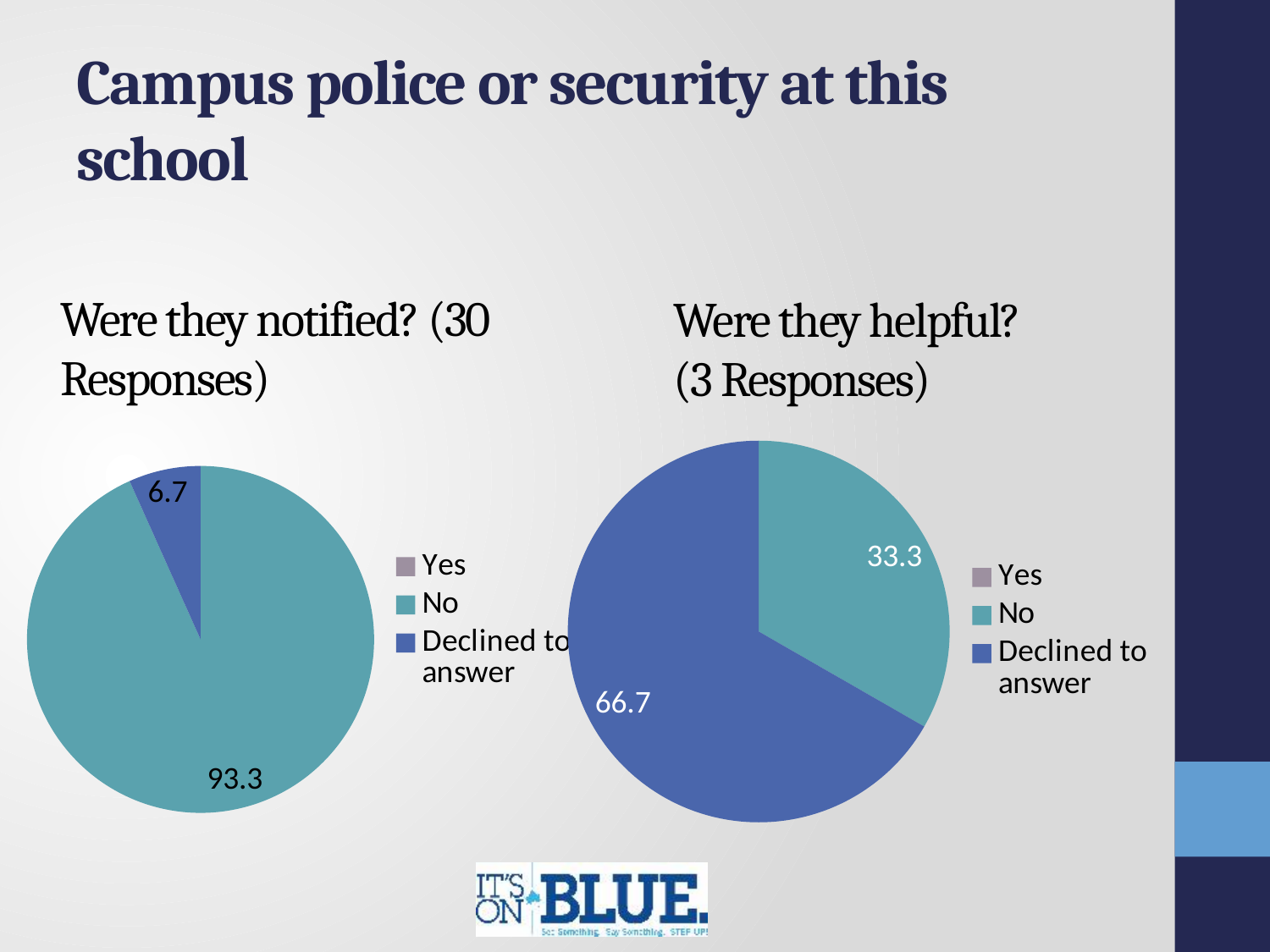
In the 'Were they notified?' chart, what is the difference between the No and Declined to answer values? 86.6 In the 'Were they helpful?' chart, which category has the largest slice? Declined to answer In the 'Were they helpful?' chart, which is larger, No or Declined to answer? Declined to answer In the 'Were they notified?' chart, what is the value for No? 93.3 How many entries does the legend of the 'Were they helpful?' chart list? 3 In the 'Were they helpful?' chart, what is the value for No? 33.3 In the 'Were they notified?' chart, which category has the largest slice? No In the 'Were they helpful?' chart, what is the value for Declined to answer? 66.7 In the 'Were they notified?' chart, what is the value for Declined to answer? 6.7 What type of chart is used for 'Were they notified?'? Pie chart How many responses does the 'Were they notified?' chart title say it is based on? 30 In the 'Were they helpful?' chart, what is the difference between the Declined to answer and No values? 33.4